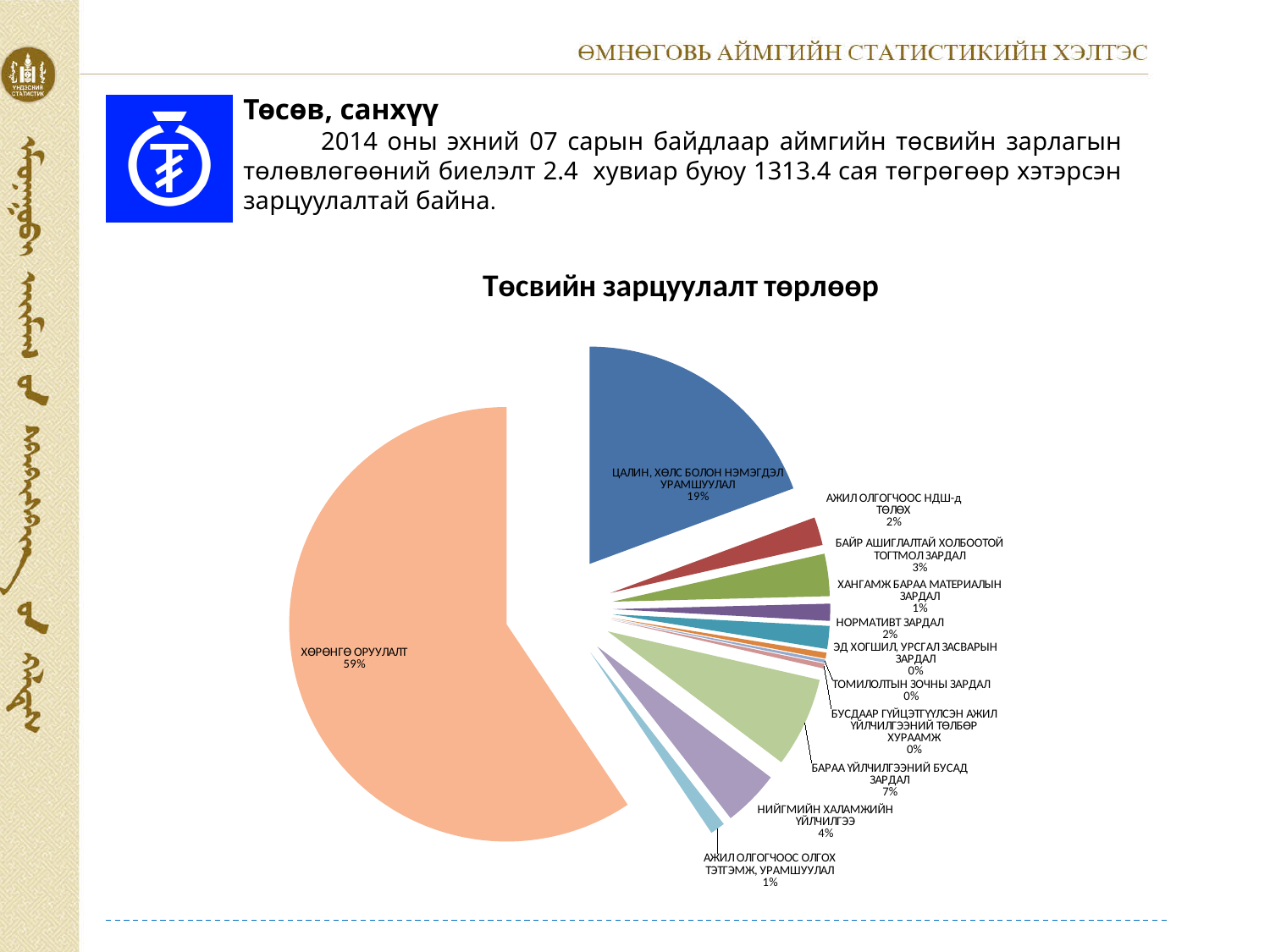
What percentage is shown for НОРМАТИВТ ЗАРДАЛ? 2% What is the title of the chart? Төсвийн зарцуулалт төрлөөр Which is larger, the share for ЦАЛИН, ХӨЛС БОЛОН НЭМЭГДЭЛ УРАМШУУЛАЛ or the share for БАРАА ҮЙЛЧИЛГЭЭНИЙ БУСАД ЗАРДАЛ? ЦАЛИН, ХӨЛС БОЛОН НЭМЭГДЭЛ УРАМШУУЛАЛ What percentage is shown for НИЙГМИЙН ХАЛАМЖИЙН ҮЙЛЧИЛГЭЭ? 4% What share of the pie does ЦАЛИН, ХӨЛС БОЛОН НЭМЭГДЭЛ УРАМШУУЛАЛ represent? 19% What percentage is shown for БАЙР АШИГЛАЛТАЙ ХОЛБООТОЙ ТОГТМОЛ ЗАРДАЛ? 3% What kind of chart is shown on the slide? pie chart How many slices does the pie chart have? 12 Which category has the largest slice of the pie? ХӨРӨНГӨ ОРУУЛАЛТ What percentage is shown for БАРАА ҮЙЛЧИЛГЭЭНИЙ БУСАД ЗАРДАЛ? 7% What share of the pie does ХӨРӨНГӨ ОРУУЛАЛТ represent? 59% What is the difference in percentage points between ХӨРӨНГӨ ОРУУЛАЛТ and ЦАЛИН, ХӨЛС БОЛОН НЭМЭГДЭЛ УРАМШУУЛАЛ? 40